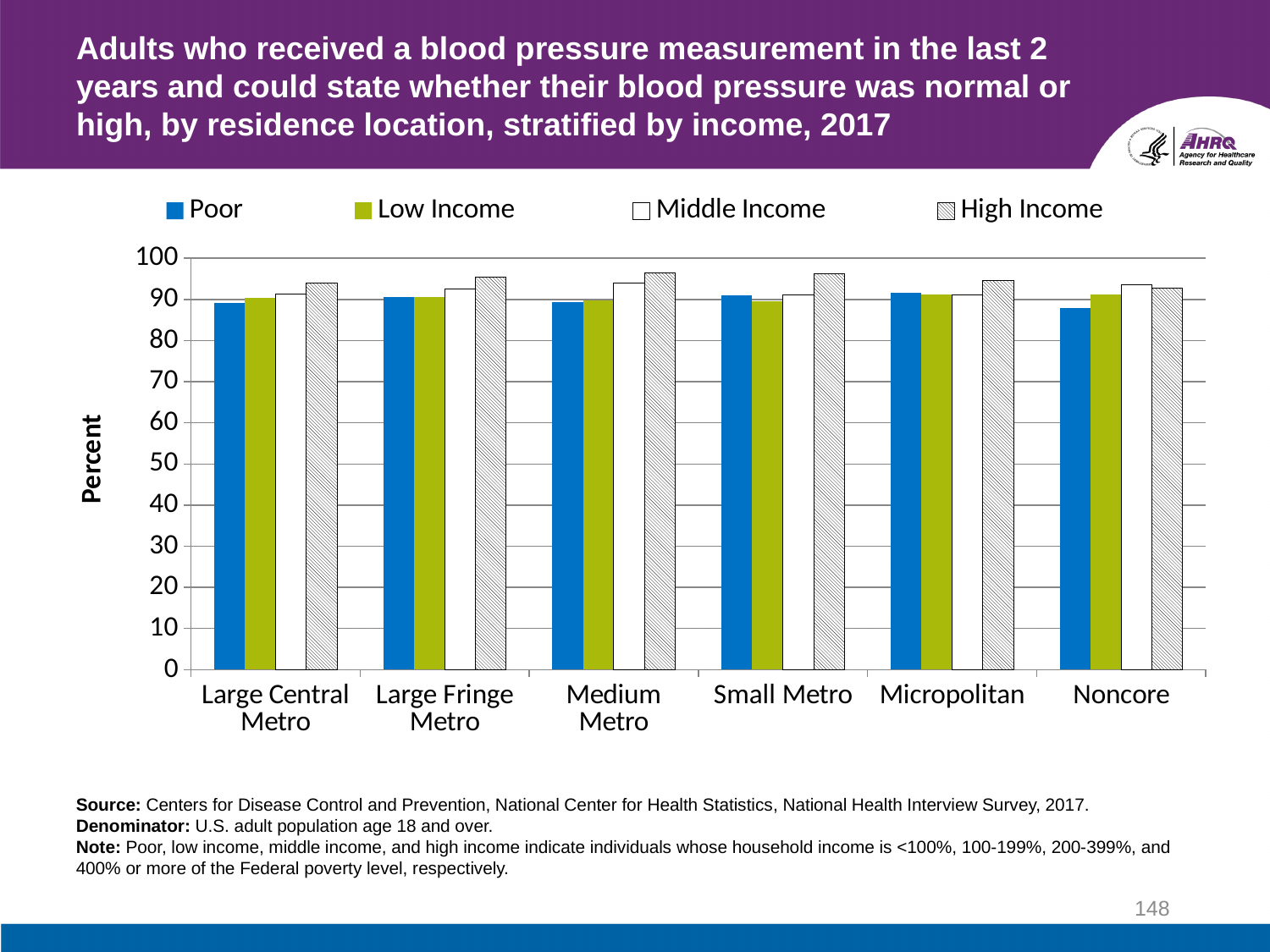
In Noncore, which is larger: the value for Poor or the value for Middle Income? Middle Income Is the value for Poor in Noncore greater or less than 90? less What is the label on the vertical axis? Percent In Medium Metro, which is larger: the value for Poor or the value for High Income? High Income Is the value for High Income in Medium Metro greater or less than 90? greater How many series does the legend list? 4 What kind of chart is shown on the slide? Bar chart How many residence location categories are shown on the x axis? 6 Is the value for High Income in Small Metro greater or less than 100? less Which income groups are listed in the legend? Poor, Low Income, Middle Income, High Income In Small Metro, which is larger: the value for Low Income or the value for High Income? High Income